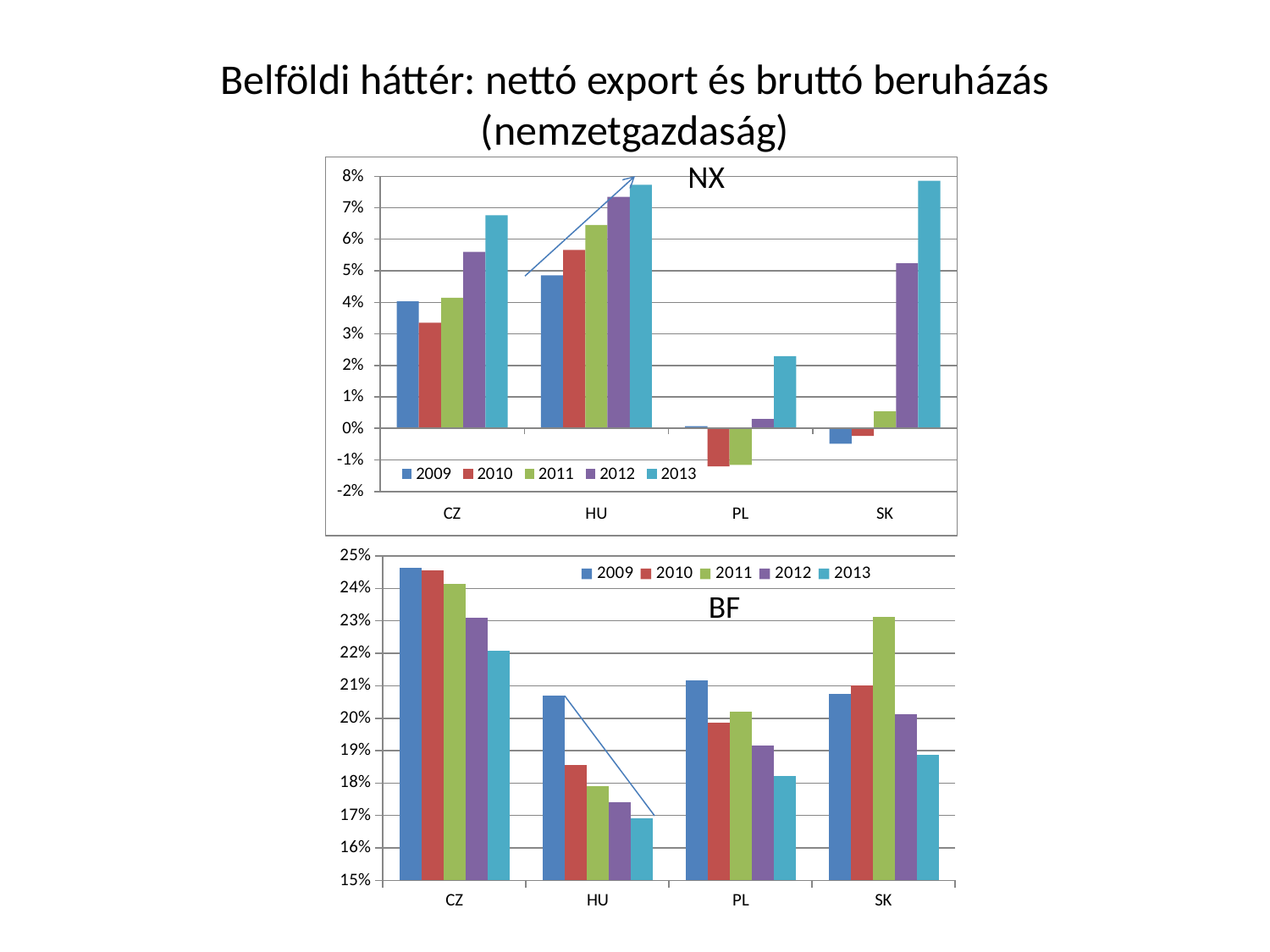
In the NX chart, do the values for HU rise or fall from 2009 to 2013? rise In the BF chart, is the value for PL in 2013 greater or less than 19%? less In the BF chart, do the values for CZ rise or fall from 2009 to 2013? fall In the BF chart, which country has the lowest value for 2013? HU In the NX chart, is the value for HU in 2009 greater or less than 4%? greater In the NX chart, which is larger for CZ: the 2009 value or the 2010 value? 2009 In the NX chart, which country has the lowest value for 2010? PL What kind of chart is the top chart labelled NX? bar chart In the BF chart, which country has the highest value for 2009? CZ In the NX chart, how many series does the legend list? 5 In the NX chart, is the value for CZ in 2013 greater or less than 6%? greater In the NX chart, how many countries are shown on the x axis? 4